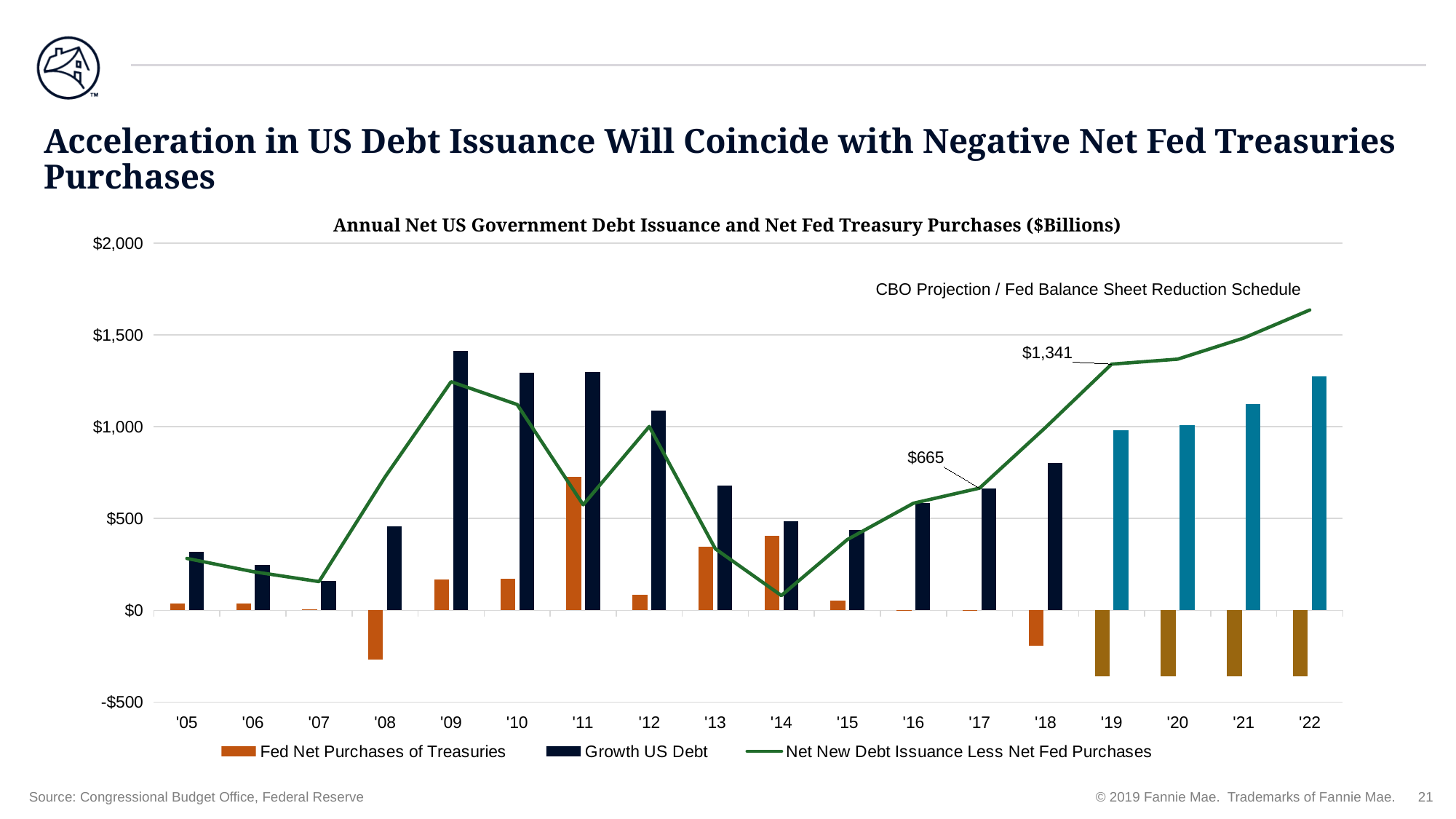
How many series does the legend list? 3 In which year is the Net New Debt Issuance Less Net Fed Purchases line at its lowest point? '14 Which is larger, the Growth US Debt bar for '12 or for '13? '12 What kind of chart is shown on the slide? A combined bar and line chart Is the Growth US Debt value for '09 greater or less than $1,000? greater What annotation text appears in the upper right of the chart area? CBO Projection / Fed Balance Sheet Reduction Schedule Does the Net New Debt Issuance Less Net Fed Purchases line rise or fall from '14 to '22? rise What is the labelled value of Net New Debt Issuance Less Net Fed Purchases in '17? $665 What is the labelled value of Net New Debt Issuance Less Net Fed Purchases in '19? $1,341 How many years are shown along the x axis? 18 In which year is the Growth US Debt bar highest? '09 What is the difference between the labelled values of Net New Debt Issuance Less Net Fed Purchases in '19 and '17? $676